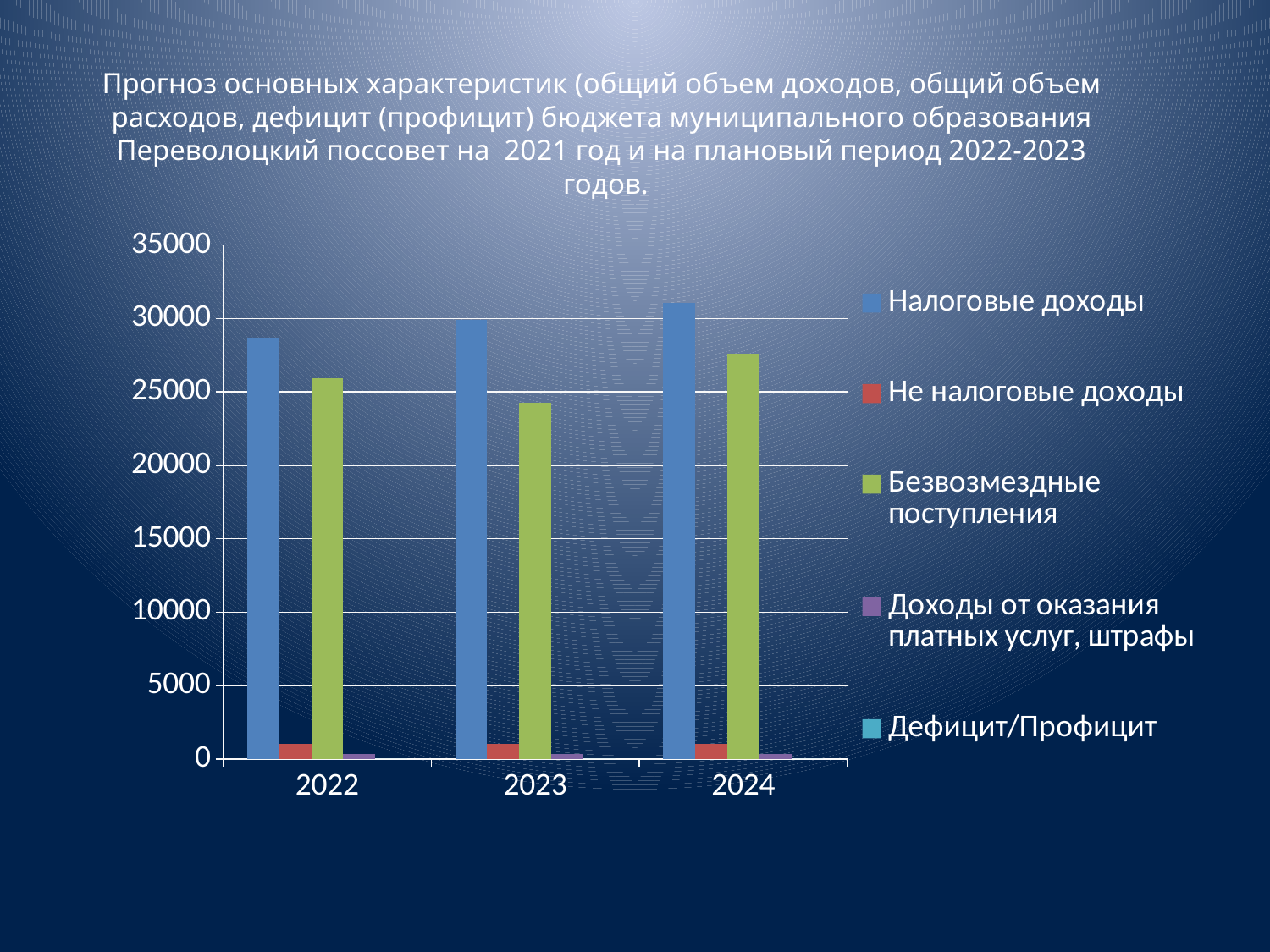
How many series does the chart legend list? 5 Is the value for Не налоговые доходы in 2022 greater or less than 5000? less In 2022, which is larger: Налоговые доходы or Безвозмездные поступления? Налоговые доходы Is the value for Налоговые доходы in 2022 greater or less than 30000? less Is the value for Безвозмездные поступления in 2024 greater or less than 25000? greater How many years are shown on the x axis of the chart? 3 Do the values for Налоговые доходы rise or fall from 2022 to 2024? rise In which year is Налоговые доходы the highest? 2024 In which year is Безвозмездные поступления the lowest? 2023 What kind of chart is shown on the slide? bar chart